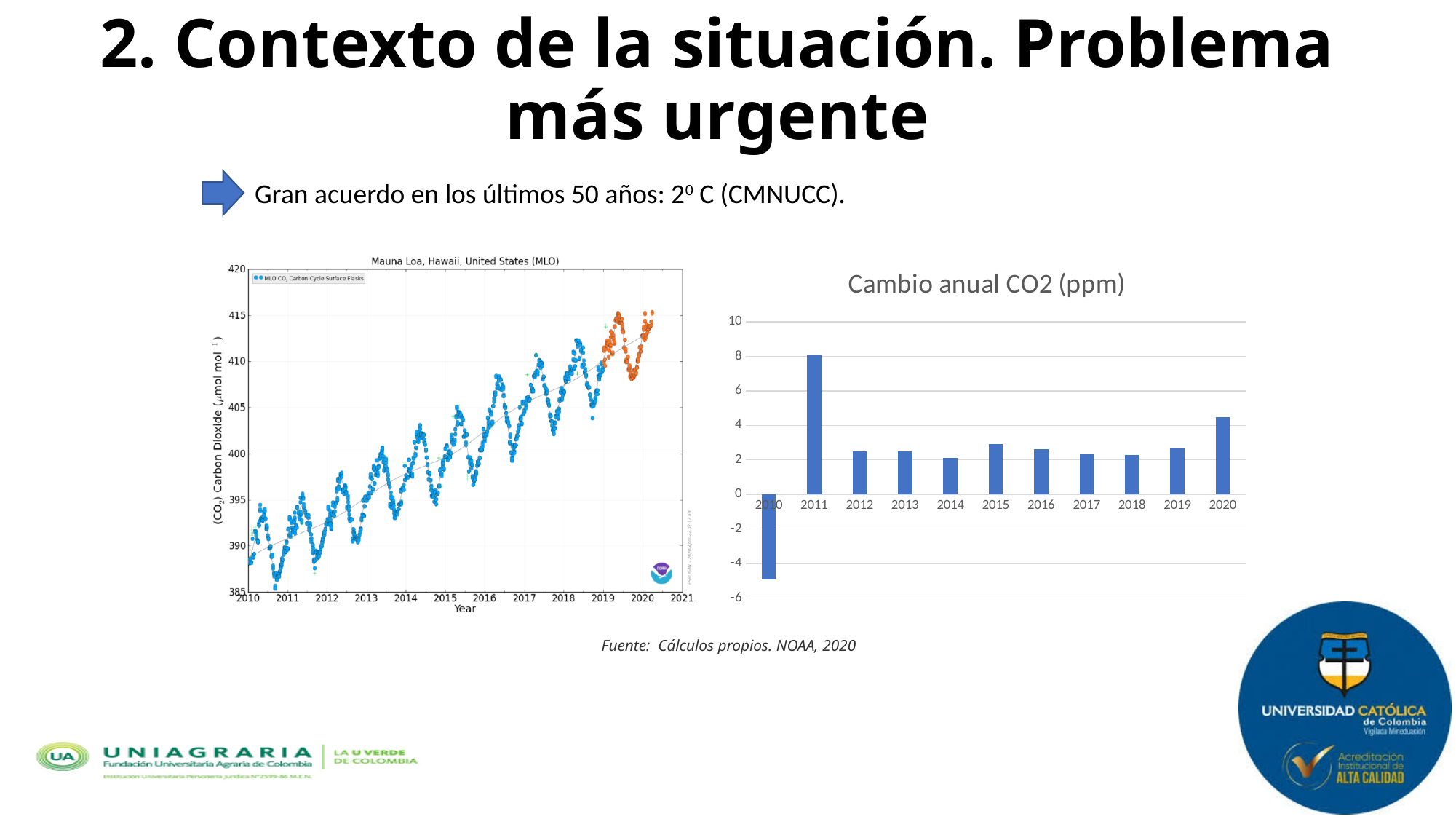
In the chart titled "Cambio anual CO2 (ppm)", which is larger, the value for 2011 or the value for 2020? 2011 In the chart titled "Cambio anual CO2 (ppm)", what kind of chart is it? bar chart In the chart titled "Cambio anual CO2 (ppm)", which year has the highest value? 2011 What is the title of the chart on the left of the slide? Mauna Loa, Hawaii, United States (MLO) In the chart titled "Cambio anual CO2 (ppm)", is the value for 2011 greater or less than 6? greater In the chart titled "Cambio anual CO2 (ppm)", is the value for 2010 greater or less than 0? less In the chart on the left titled "Mauna Loa, Hawaii, United States (MLO)", do the CO2 values generally rise or fall from 2010 to 2020? rise In the chart titled "Cambio anual CO2 (ppm)", is the value for 2020 greater or less than 4? greater In the chart titled "Cambio anual CO2 (ppm)", how many years are shown on the x axis? 11 In the chart titled "Cambio anual CO2 (ppm)", which is larger, the value for 2020 or the value for 2015? 2020 In the chart titled "Cambio anual CO2 (ppm)", which year has the lowest value? 2010